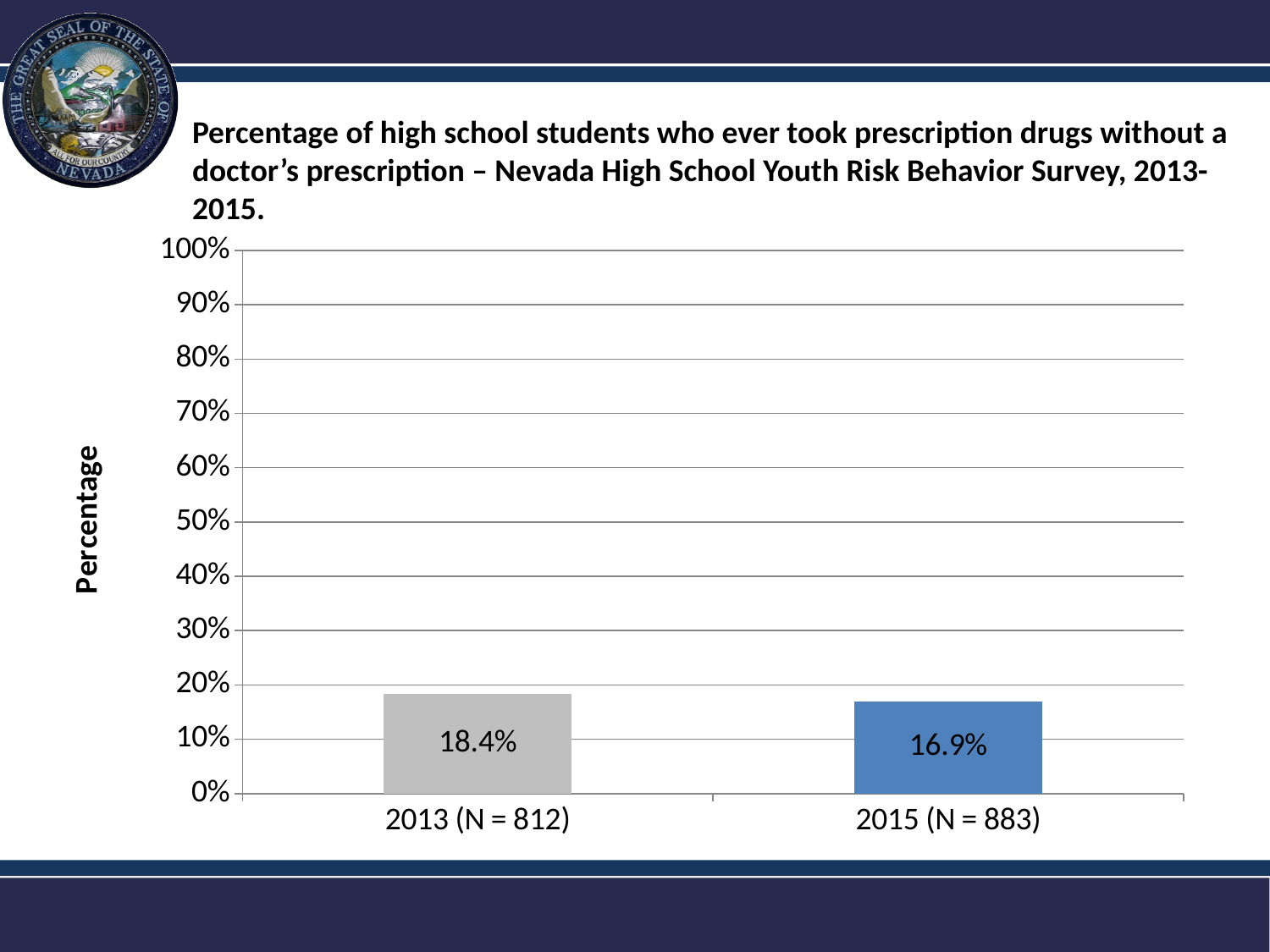
Is the value for 2013 (N = 812) greater or less than 10%? greater What is the difference between the 2013 and 2015 values? 1.5% What is the label of the y axis? Percentage What is the value for 2015 (N = 883)? 16.9% Which is larger, the value for 2013 (N = 812) or 2015 (N = 883)? 2013 (N = 812) Which category has the lowest value? 2015 (N = 883) What is the value for 2013 (N = 812)? 18.4% How many categories are shown on the x axis? 2 Which category has the highest value? 2013 (N = 812) What kind of chart is shown on the slide? bar chart Do the values rise or fall from 2013 to 2015? fall Is the value for 2015 (N = 883) greater or less than 20%? less